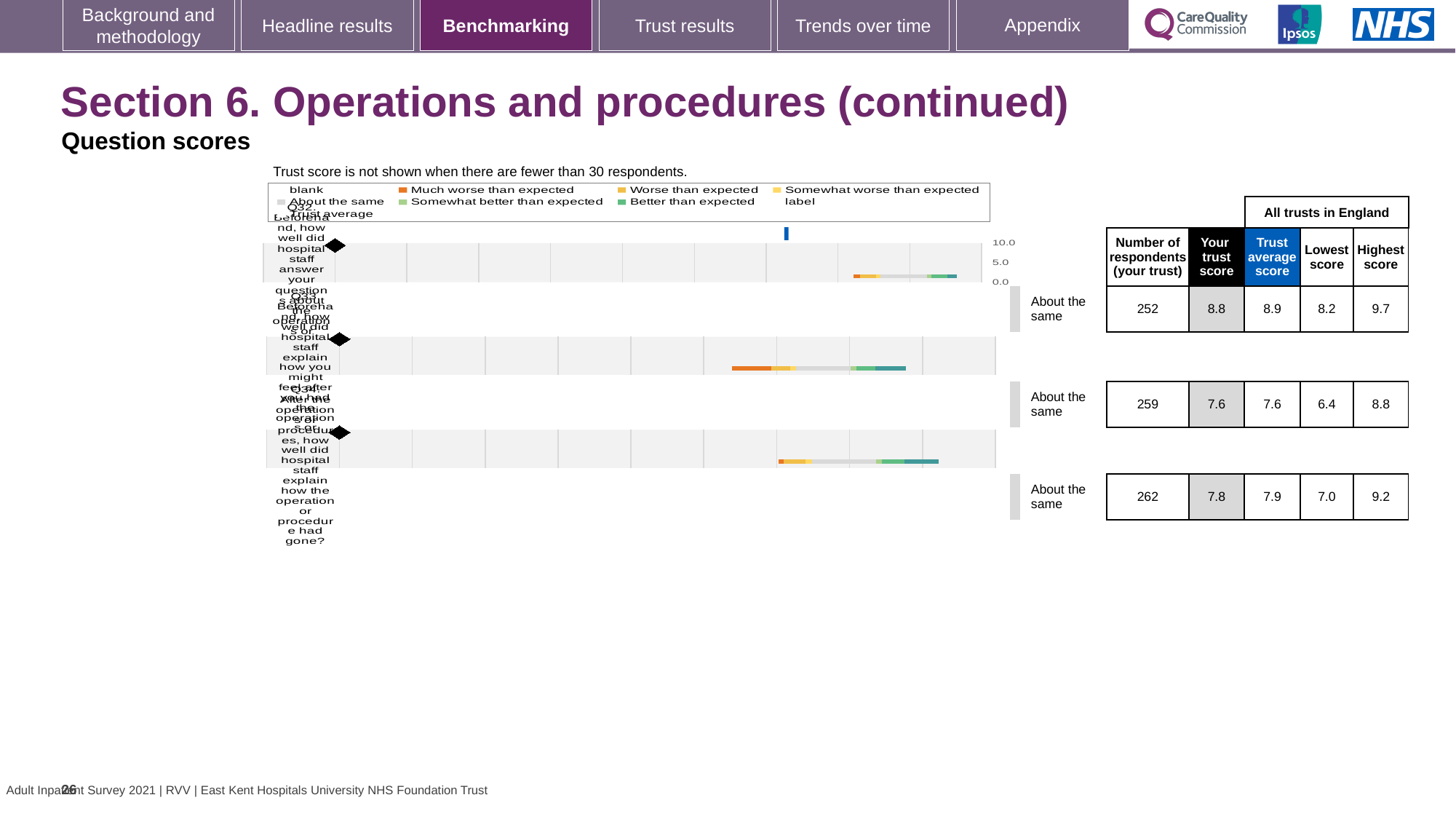
For the second question row, is 'Your trust score' greater than, less than, or equal to the 'Trust average score'? Equal For the first question row, what is the difference between the highest score (9.7) and the lowest score (8.2) across all trusts in England? 1.5 How many respondents (your trust) are shown for the second question row? 259 What is the 'Highest score' across all trusts in England for the second question row? 8.8 Which question row has the highest 'Your trust score'? The first (top) row, 8.8 For the third question row, is 'Your trust score' higher or lower than the 'Trust average score'? Lower What benchmark category is shown next to each of the three question rows? About the same How many question rows are plotted in the benchmarking chart? 3 What is the 'Trust average score' for the third (bottom) question row? 7.9 Which question row has the lowest 'Lowest score' among all trusts in England? The second (middle) row, 6.4 What type of chart is used to show the benchmarking results? Bar chart What is the 'Your trust score' value for the first (top) question row in the benchmarking chart? 8.8